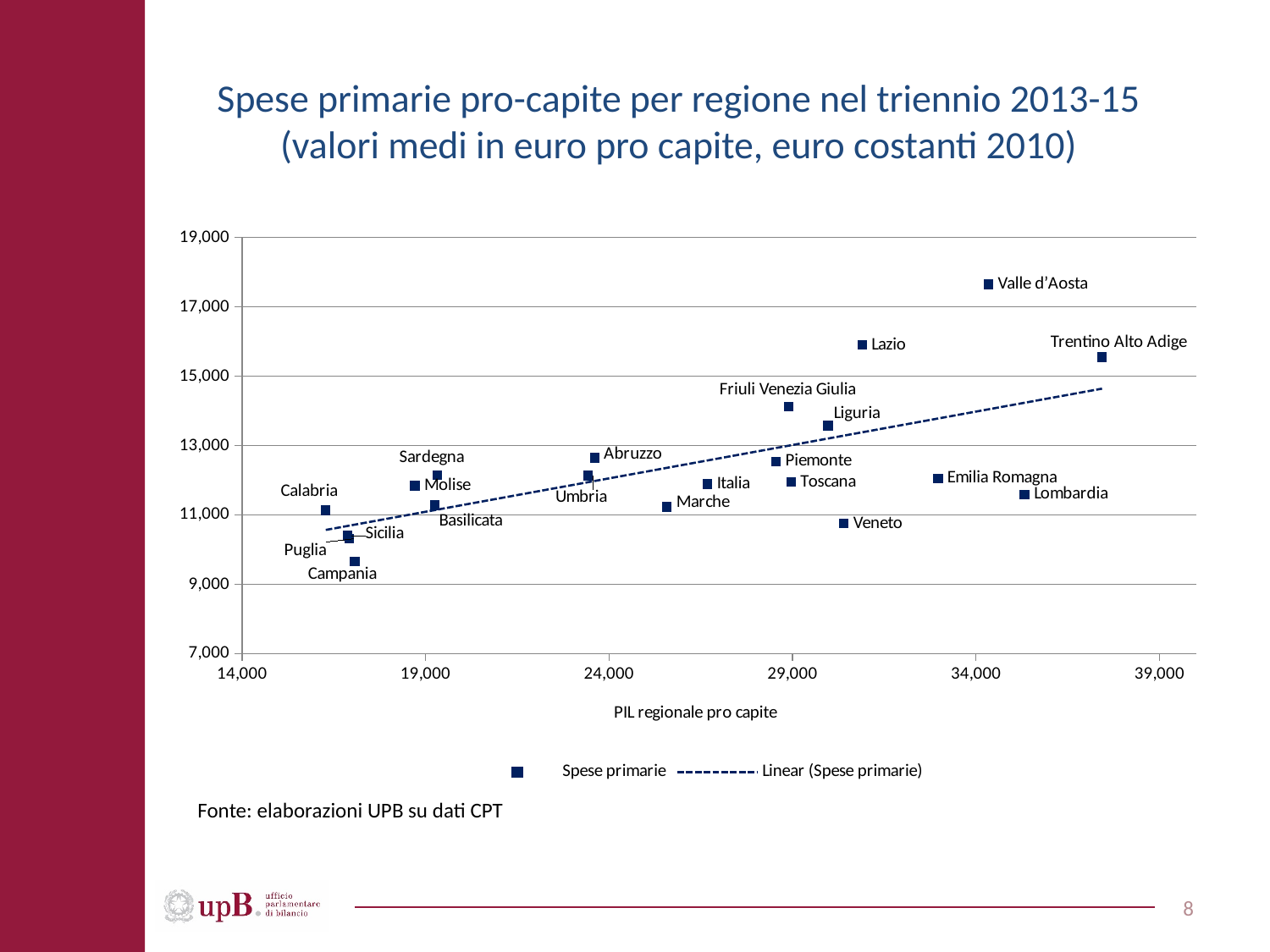
What is the title of the horizontal axis? PIL regionale pro capite Is the value for Veneto greater or less than 11,000? less Does the dashed linear trend line rise or fall as regional GDP per capita (PIL regionale pro capite) increases? rises What kind of chart is shown on the slide? scatter chart How many entries does the legend list? 2 Which region has the highest primary spending per capita (Spese primarie) on the chart? Valle d'Aosta Which region has the lowest primary spending per capita on the chart? Campania Which has higher primary spending per capita, Lazio or Veneto? Lazio Is the value for Valle d'Aosta greater or less than 17,000? greater Is the value for Lazio greater or less than 15,000? greater Which has higher primary spending per capita, Friuli Venezia Giulia or Campania? Friuli Venezia Giulia